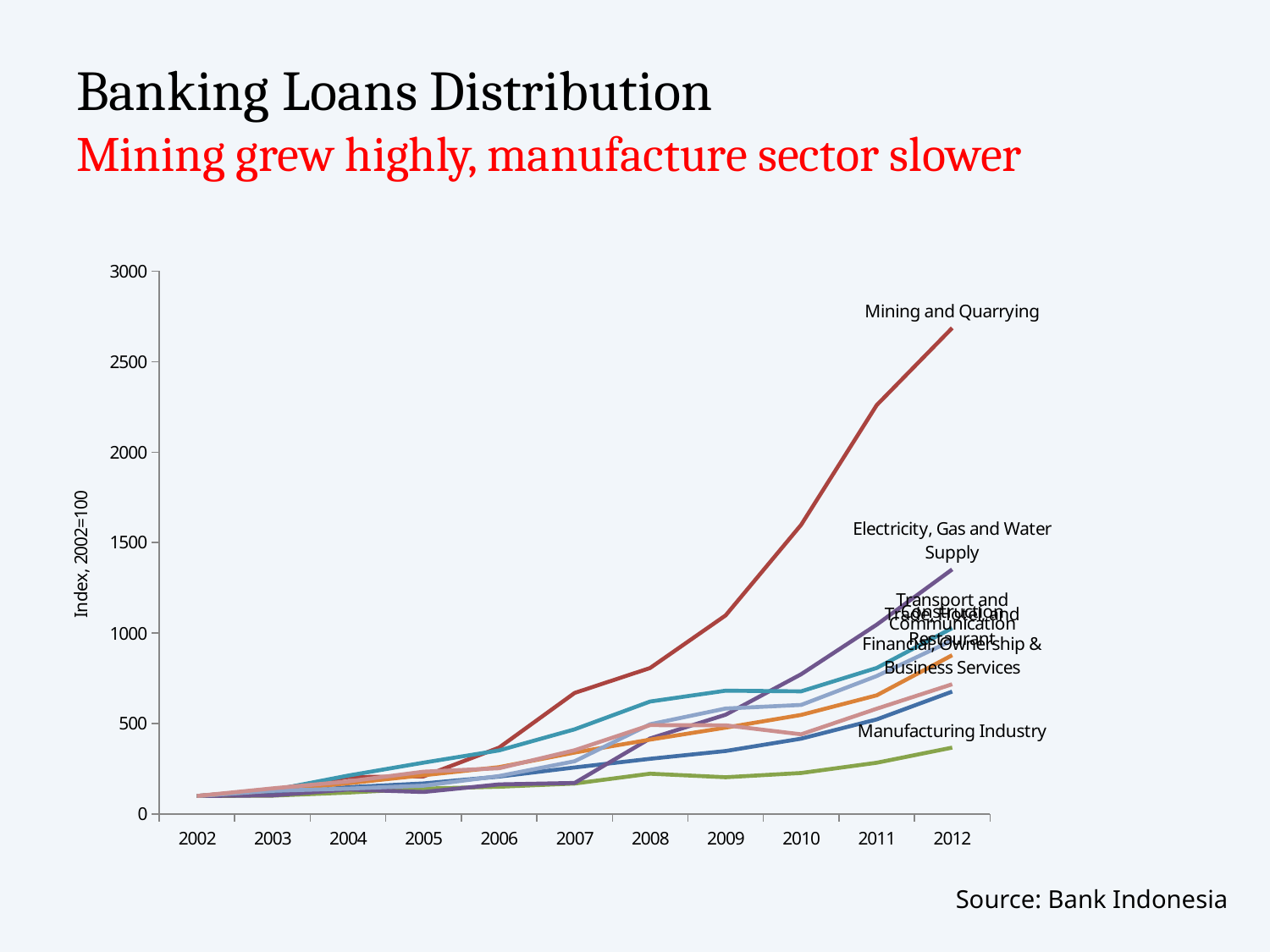
What kind of chart is shown on the slide? line chart What is the source cited for the chart data? Bank Indonesia Is the value for Mining and Quarrying in 2012 greater or less than 2500? greater Does the Mining and Quarrying line rise or fall from 2002 to 2012? rise Which series has the highest value in 2012? Mining and Quarrying Is the value for Manufacturing Industry in 2012 greater or less than 500? less Is the value for Electricity, Gas and Water Supply in 2012 greater or less than 1500? less How many years are plotted along the x axis? 11 In 2012, which is larger: Electricity, Gas and Water Supply or Manufacturing Industry? Electricity, Gas and Water Supply Which series has the lowest value in 2012? Manufacturing Industry What is the index value of the series in the base year 2002, according to the y-axis label? 100